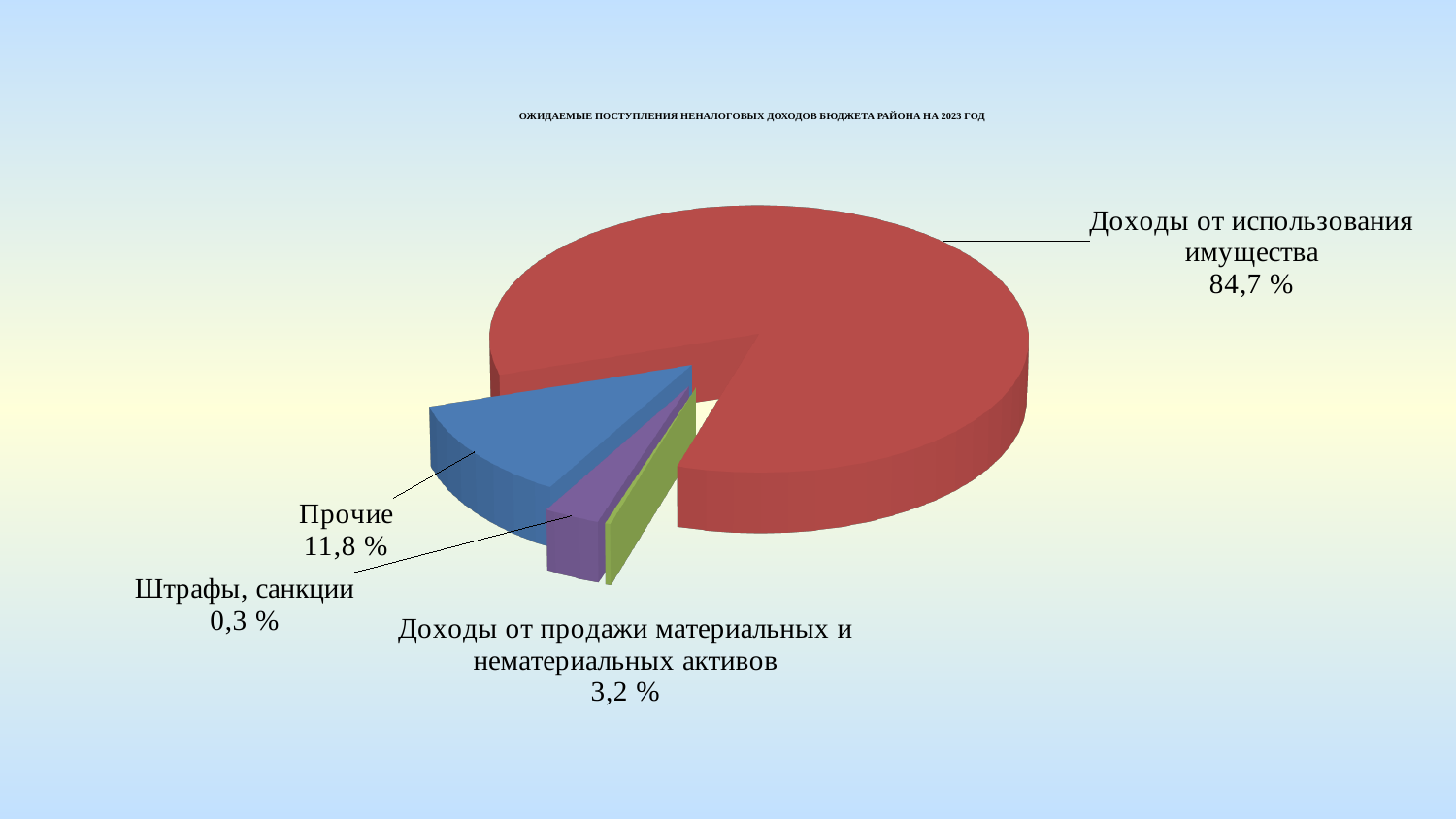
What share of the pie does Доходы от продажи материальных и нематериальных активов have? 3,2 % What colour is the slice for Доходы от использования имущества? Red What share of the pie does Прочие have? 11,8 % What is the difference between the shares of Доходы от использования имущества and Прочие? 72,9 % What is the difference between the shares of Доходы от продажи материальных и нематериальных активов and Штрафы, санкции? 2,9 % What kind of chart is shown on the slide? Pie chart How many slices does the pie chart have? 4 What share of the pie does Доходы от использования имущества have? 84,7 % What share of the pie does Штрафы, санкции have? 0,3 % Which is larger: the share of Прочие or the share of Доходы от продажи материальных и нематериальных активов? Прочие Which category has the smallest share of the pie? Штрафы, санкции Which category has the largest share of the pie? Доходы от использования имущества